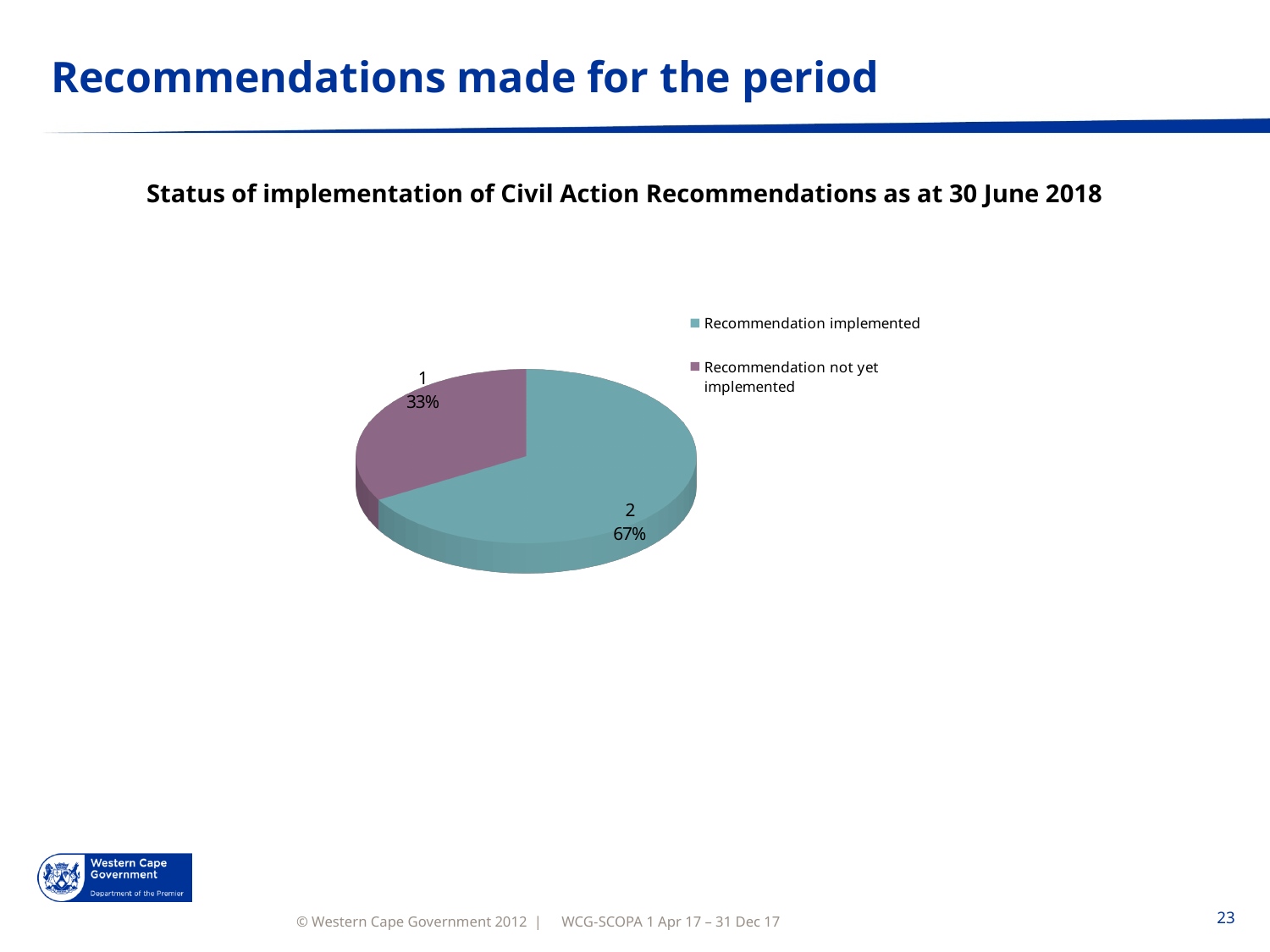
How many recommendations were not yet implemented? 1 What share of the pie is 'Recommendation implemented'? 67% How many categories does the pie chart have? 2 How many recommendations were implemented? 2 Which category has the smallest slice of the pie? Recommendation not yet implemented Which is larger: the number of recommendations implemented or not yet implemented? Recommendation implemented What is the total number of recommendations shown in the pie chart? 3 What kind of chart is shown on the slide? Pie chart What is the title of the chart? Status of implementation of Civil Action Recommendations as at 30 June 2018 Which category has the largest slice of the pie? Recommendation implemented What share of the pie is 'Recommendation not yet implemented'? 33% What is the difference between the number of recommendations implemented and not yet implemented? 1